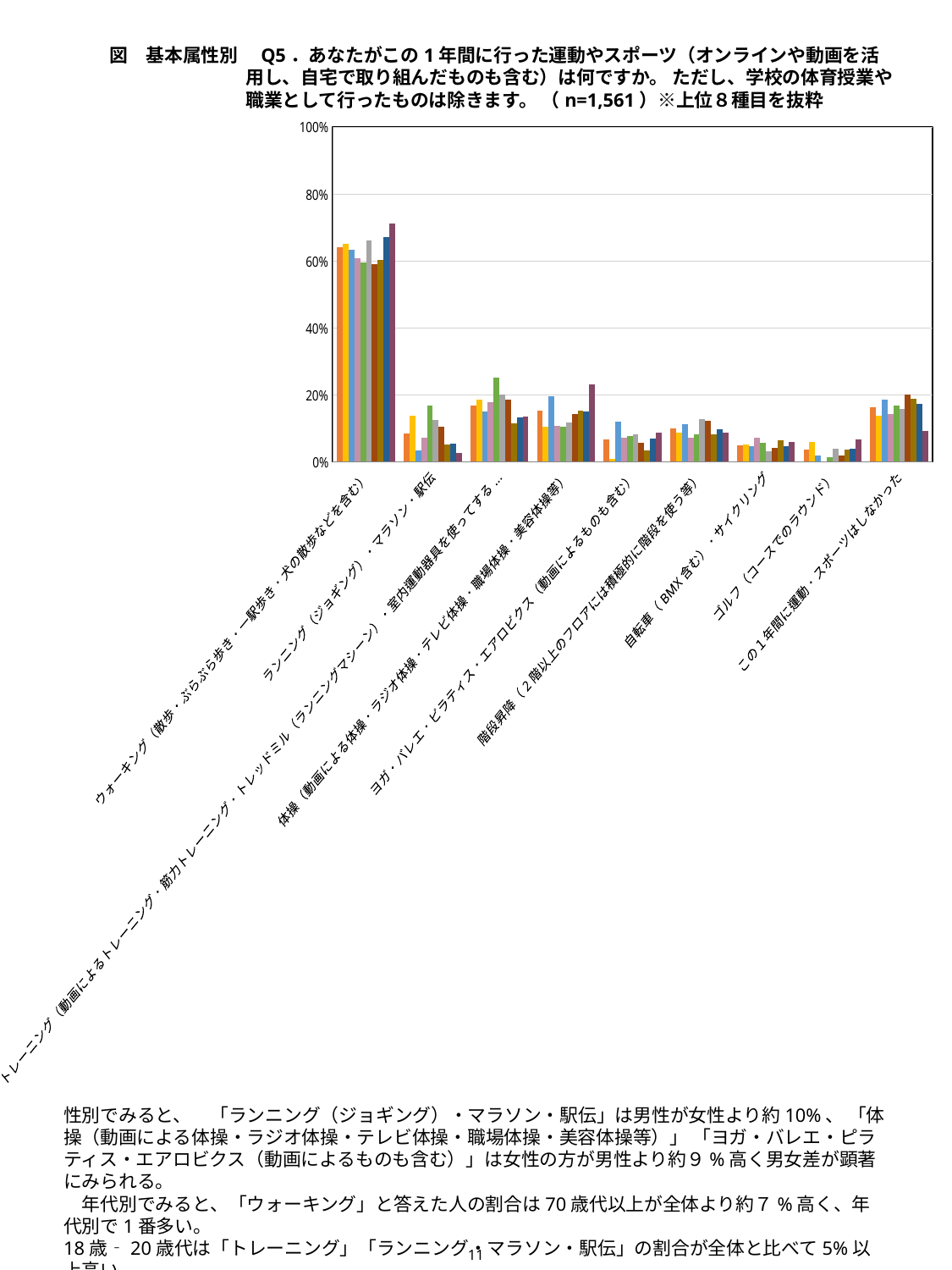
How many categories are shown along the x axis of the chart? 9 What is the highest value shown on the chart's y axis? 100% What kind of chart is shown on the slide? bar chart Are the bars for この1年間に運動・スポーツはしなかった greater or less than 40%? less Which category has larger bars, 体操（動画による体操・ラジオ体操・テレビ体操・職場体操・美容体操等） or ゴルフ（コースでのラウンド）? 体操（動画による体操・ラジオ体操・テレビ体操・職場体操・美容体操等） Are the bars for ウォーキング greater or less than 80%? less Which category has larger bars, ウォーキング or ランニング（ジョギング）・マラソン・駅伝? ウォーキング Are the bars for ウォーキング greater or less than 40%? greater What sample size (n) is stated in the chart title? n=1,561 Which category has the highest bars in the chart? ウォーキング（散歩・ぶらぶら歩き・一駅歩き・犬の散歩などを含む）